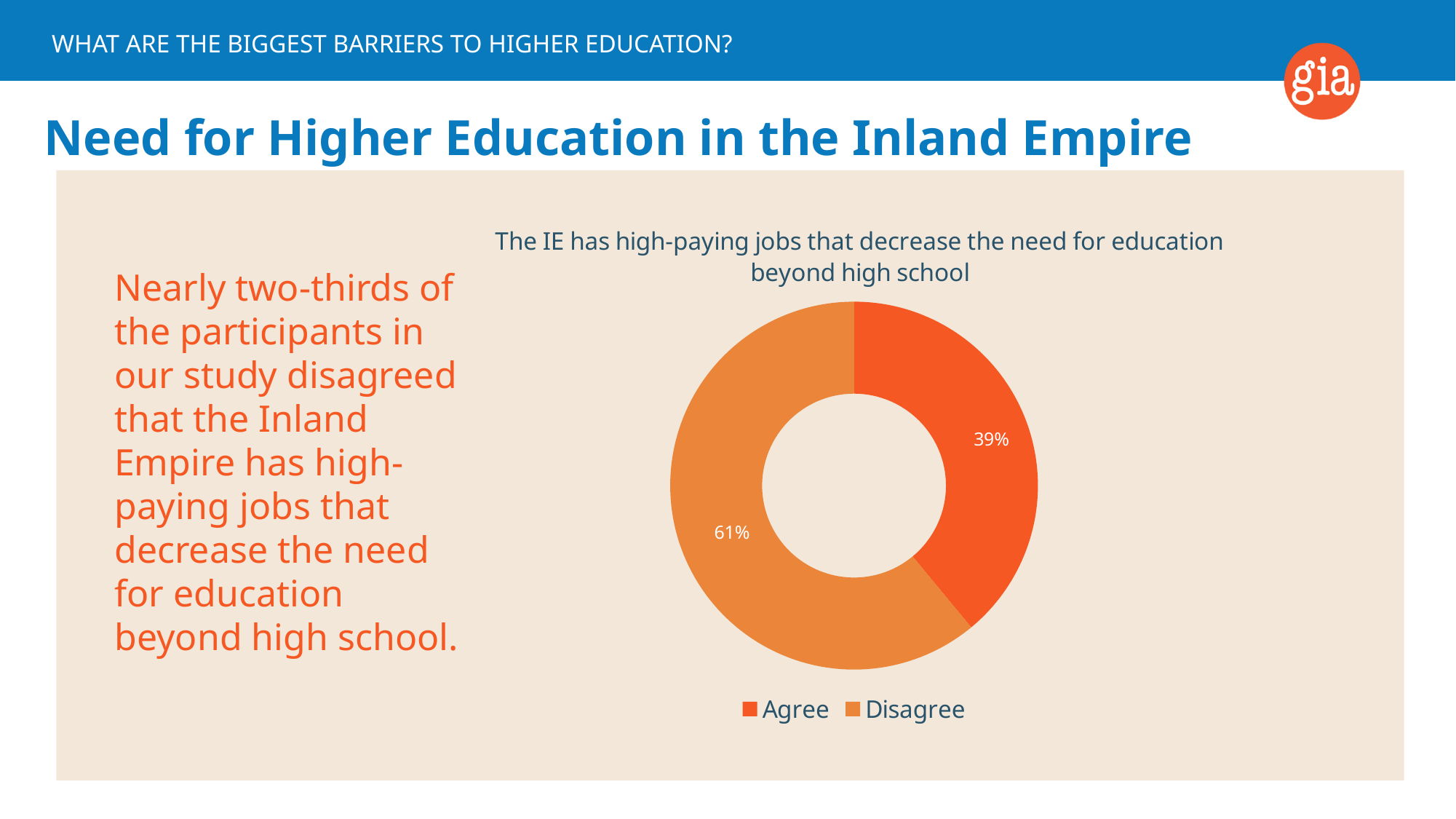
Which legend entry is shown in the darker red-orange colour? Agree How many entries does the legend list? 2 How many categories does the chart show? 2 What kind of chart is shown on the slide? Doughnut (pie) chart What is the difference in percentage points between the Disagree and Agree shares? 22 Which response has the larger share of the chart, Agree or Disagree? Disagree Is the Agree share larger or smaller than the Disagree share? smaller What percentage of participants disagree that the IE has high-paying jobs that decrease the need for education beyond high school? 61% What is the title of the chart? The IE has high-paying jobs that decrease the need for education beyond high school Which response has the smaller share of the chart? Agree What percentage of participants agree that the IE has high-paying jobs that decrease the need for education beyond high school? 39% What share of the chart does the Disagree slice represent? 61%